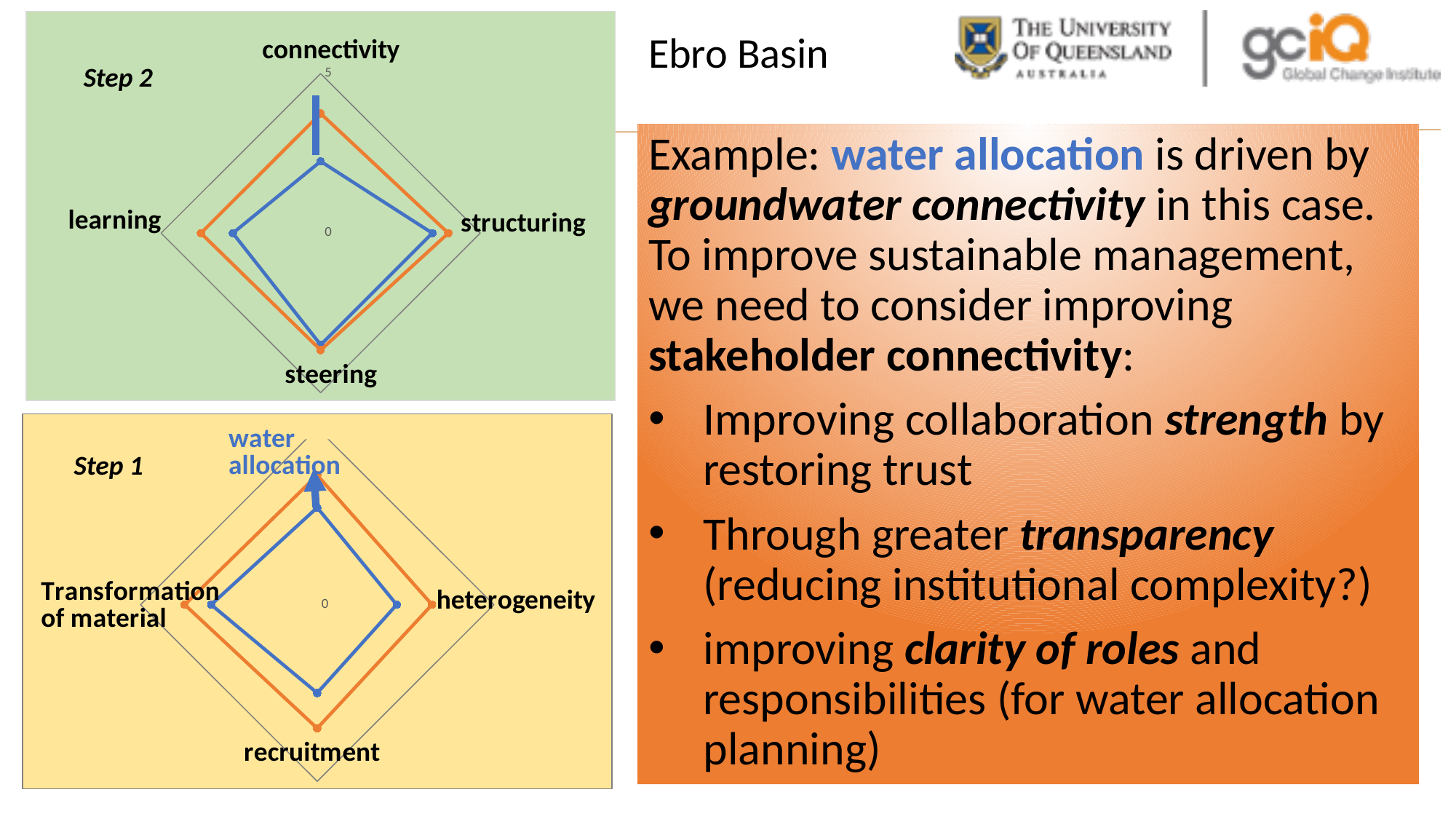
What kind of chart is the Step 1 chart at the bottom left of the slide? radar chart Which axis label on the Step 1 radar chart is written in blue text? water allocation How many axes (categories) does the Step 2 radar chart have? 4 What is the maximum value shown on the axis scale of the Step 2 radar chart? 5 In the Step 2 radar chart, is the blue series value for connectivity larger or smaller than the orange series value for connectivity? smaller In the Step 2 radar chart, is the blue series value for connectivity greater or less than 5? less How many data series are plotted on the Step 2 radar chart? 2 What kind of chart is the Step 2 chart at the top left of the slide? radar chart How many axes (categories) does the Step 1 radar chart have? 4 In the Step 1 radar chart, is the blue series value for heterogeneity larger or smaller than the orange series value for heterogeneity? smaller How many data series are plotted on the Step 1 radar chart? 2 In the Step 2 radar chart, which axis has the lowest value for the blue series? connectivity